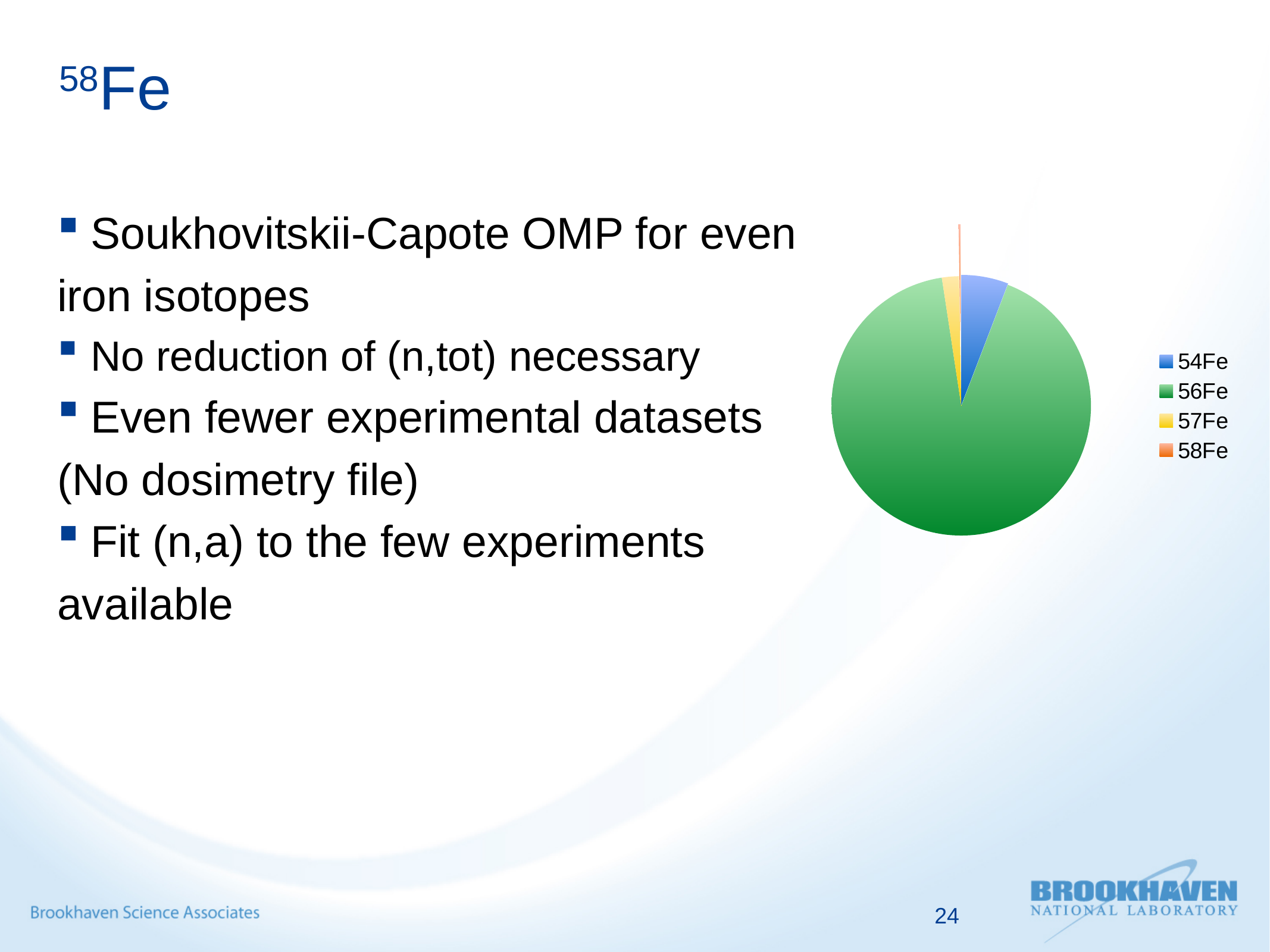
How many slices does the pie chart have? 4 Which slice is larger in the pie chart, 56Fe or 54Fe? 56Fe Which slice is larger in the pie chart, 54Fe or 57Fe? 54Fe What colour is the 56Fe slice in the pie chart? green What kind of chart is shown on the slide? pie chart Which isotope has the largest slice in the pie chart? 56Fe Does the 56Fe slice take up more or less than half of the pie chart? more How many entries does the legend of the pie chart list? 4 Which slice is larger in the pie chart, 57Fe or 58Fe? 57Fe Which isotope has the smallest slice in the pie chart? 58Fe